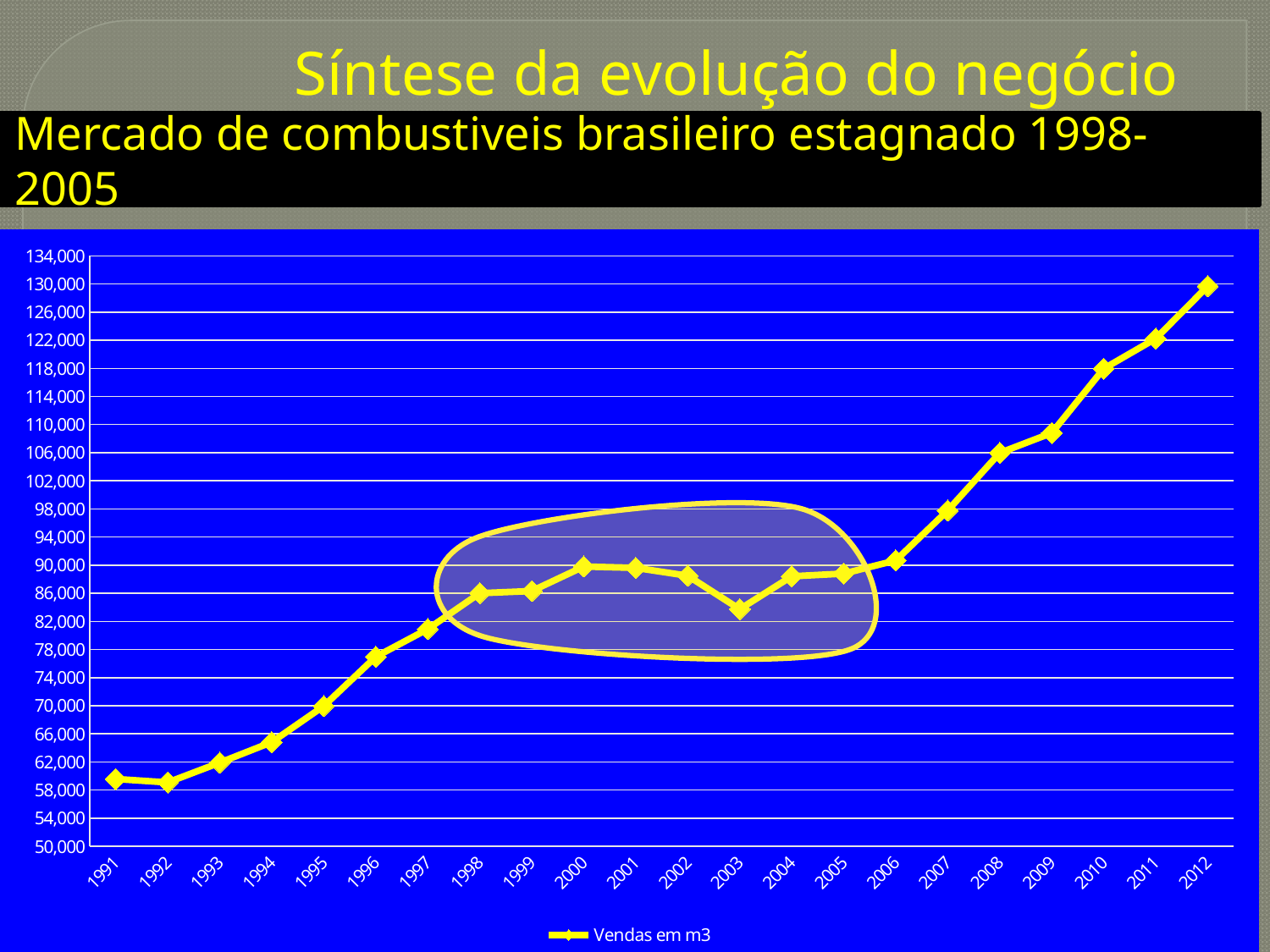
Which year has the highest value for Vendas em m3? 2012 Which year has the larger value, 2000 or 2003? 2000 Is the value for 1996 greater or less than 74,000? greater How many years are plotted along the x axis? 22 What is the name of the series shown in the legend? Vendas em m3 How many series does the legend list? 1 What kind of chart is shown on the slide? line chart Which year has the larger value, 2008 or 2005? 2008 Is the value for 2012 greater or less than 126,000? greater Is the value for 2007 greater or less than 102,000? less Overall, do the values rise or fall from 1991 to 2012? rise